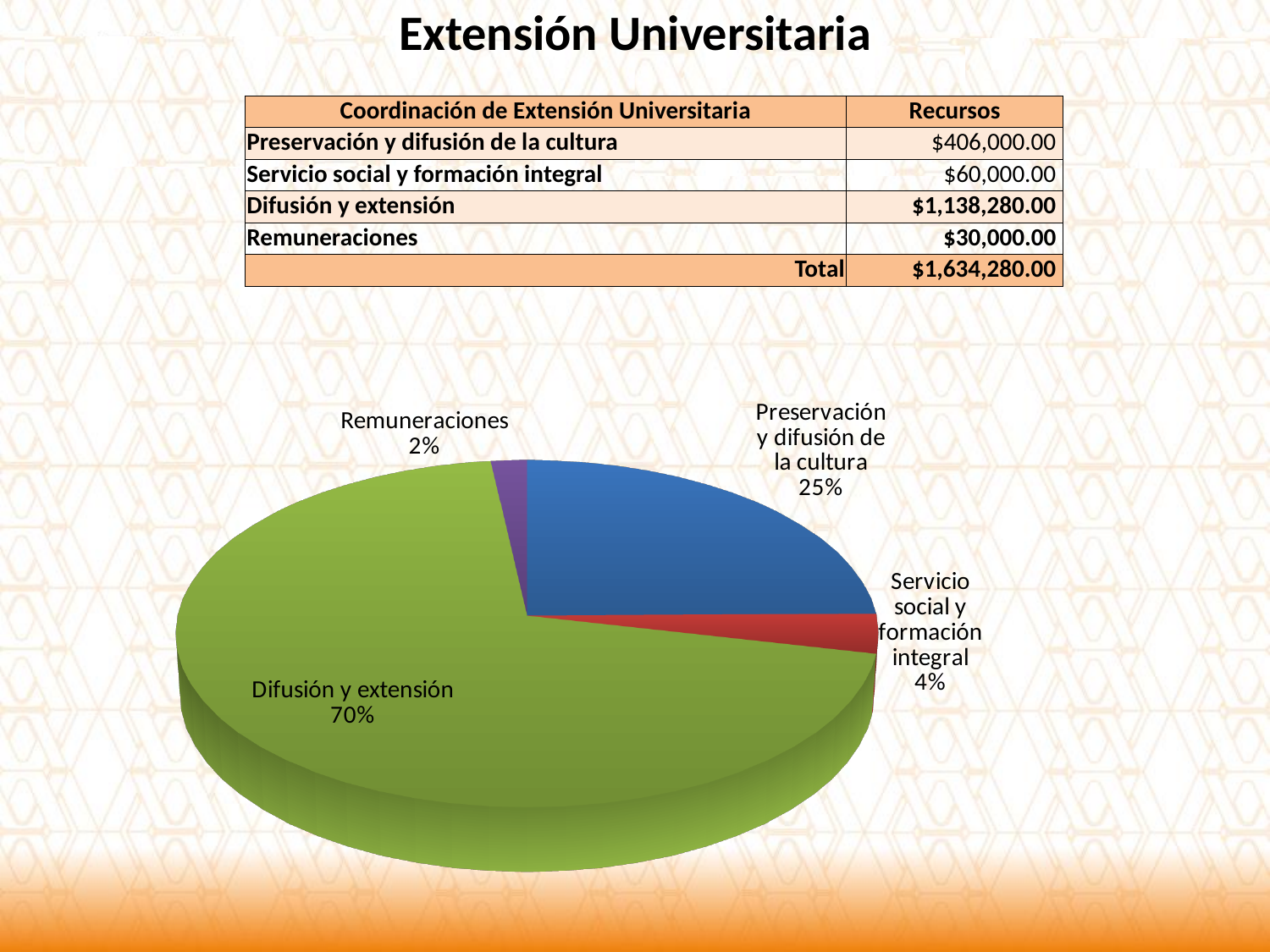
Which category has the largest slice of the pie? Difusión y extensión Which slice is larger, Preservación y difusión de la cultura or Servicio social y formación integral? Preservación y difusión de la cultura What share of the pie does Difusión y extensión represent? 70% What colour is the Preservación y difusión de la cultura slice? Blue What share of the pie does Preservación y difusión de la cultura represent? 25% What is the difference in percentage points between the Difusión y extensión slice and the Preservación y difusión de la cultura slice? 45 percentage points What kind of chart is shown on the slide? Pie chart Which category has the smallest slice of the pie? Remuneraciones What colour is the Difusión y extensión slice? Green What share of the pie does Remuneraciones represent? 2% How many slices does the pie chart have? 4